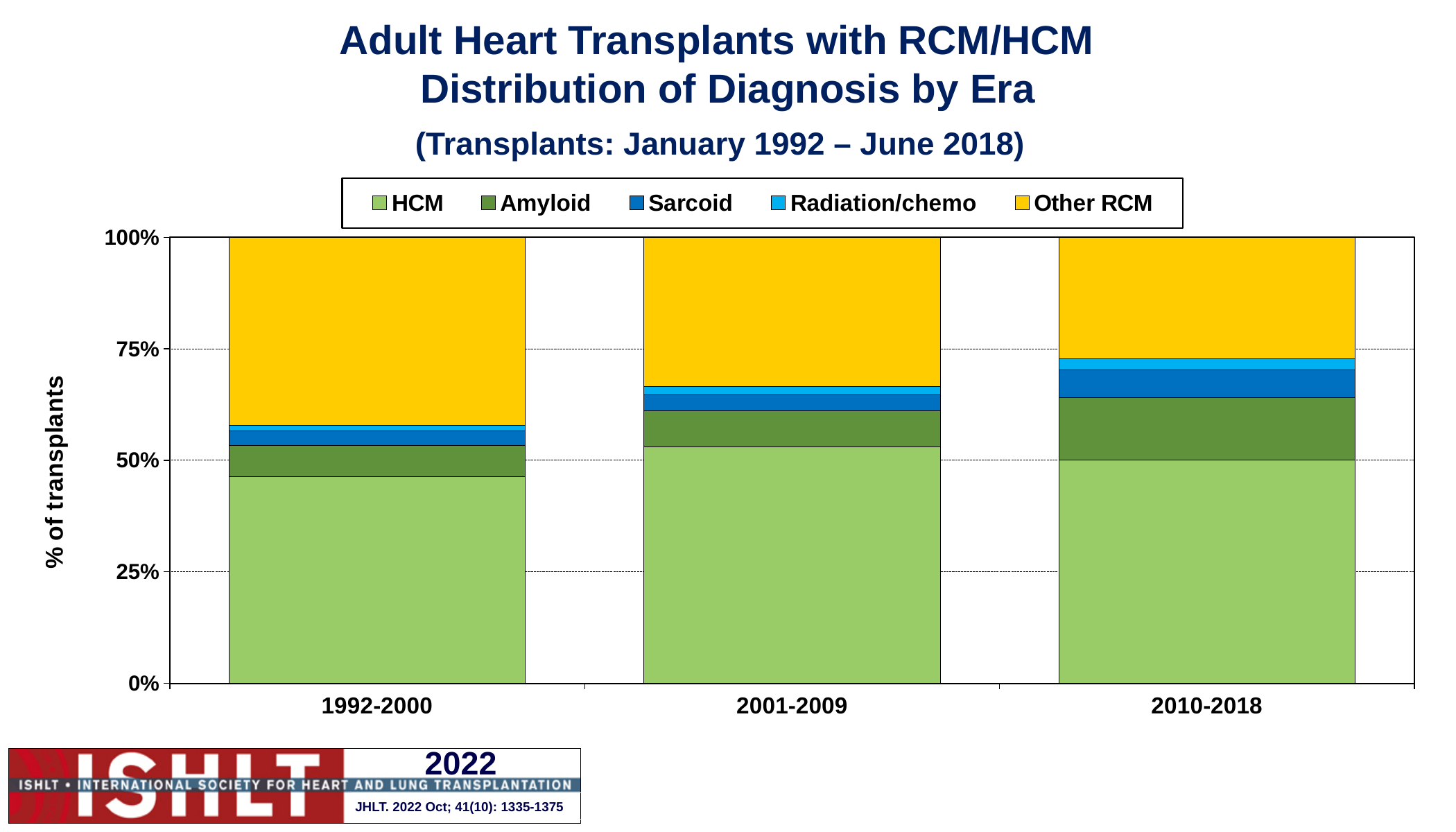
Is the Other RCM share for 1992-2000 greater or less than 25%? greater What is the label of the y axis? % of transplants How many era categories are shown on the x axis? 3 In 2010-2018, which is larger: the HCM share or the Other RCM share? HCM Is the HCM share for 2001-2009 greater or less than 50%? greater Does the Other RCM share rise or fall across the eras from 1992-2000 to 2010-2018? Fall In which era is the Amyloid segment the largest? 2010-2018 Which colour represents Other RCM in the legend? Yellow What kind of chart is shown on the slide? Stacked bar chart Is the HCM share for 1992-2000 greater or less than 50%? less How many series does the legend list? 5 In which era is the Other RCM segment the largest? 1992-2000